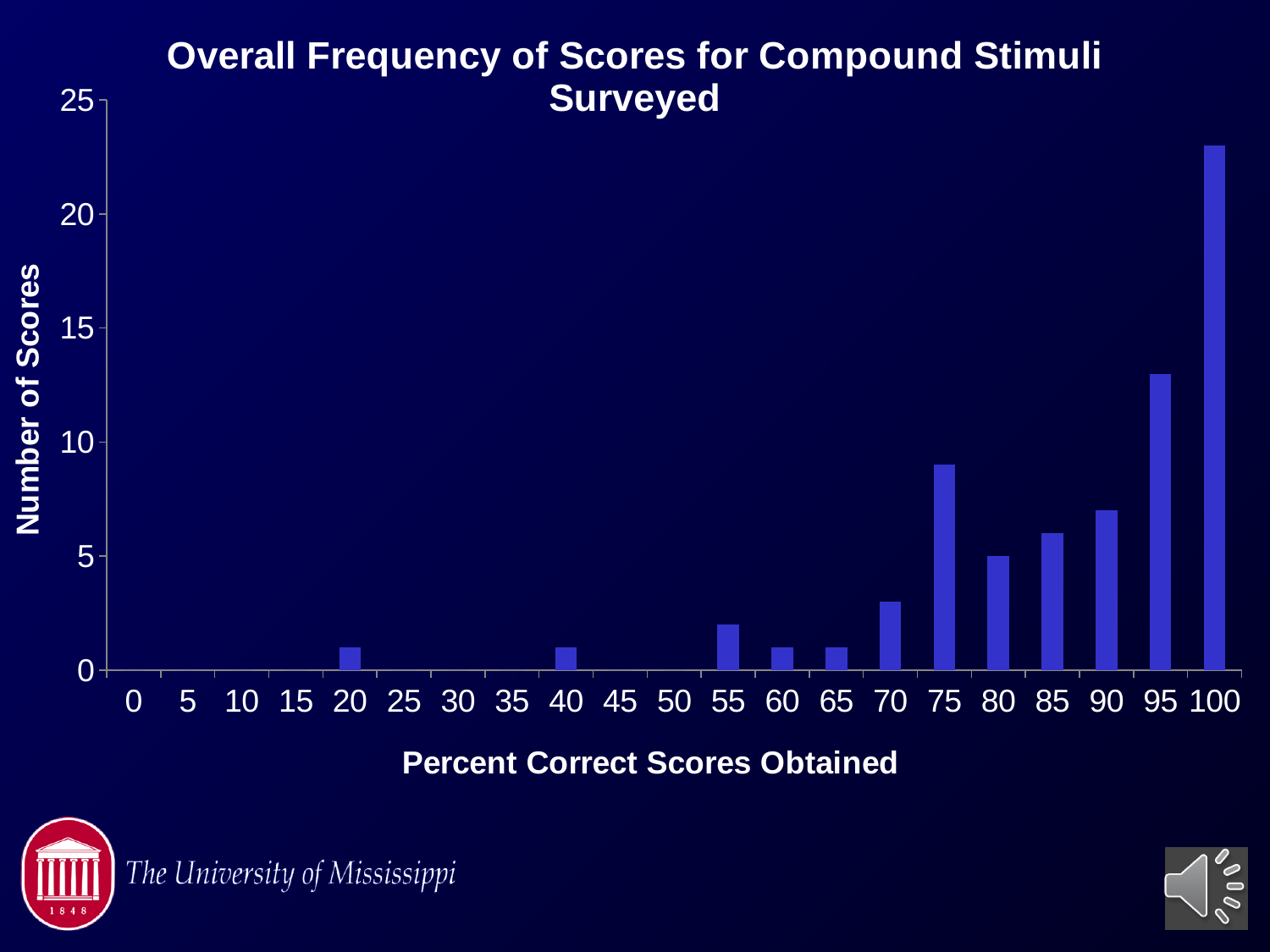
What is the title of the chart? Overall Frequency of Scores for Compound Stimuli Surveyed How many percent-correct categories are labelled on the x axis? 21 Is the number of scores for 75 percent correct greater or less than 5? greater Which has more scores, 75 percent correct or 80 percent correct? 75 Is the number of scores for 70 percent correct greater or less than 5? less Which percent correct score has the highest number of scores? 100 Is the number of scores for 95 percent correct greater or less than 15? less What is the label of the y axis? Number of Scores Which has more scores, 85 percent correct or 90 percent correct? 90 What kind of chart is shown on the slide? bar chart Which has more scores, 95 percent correct or 90 percent correct? 95